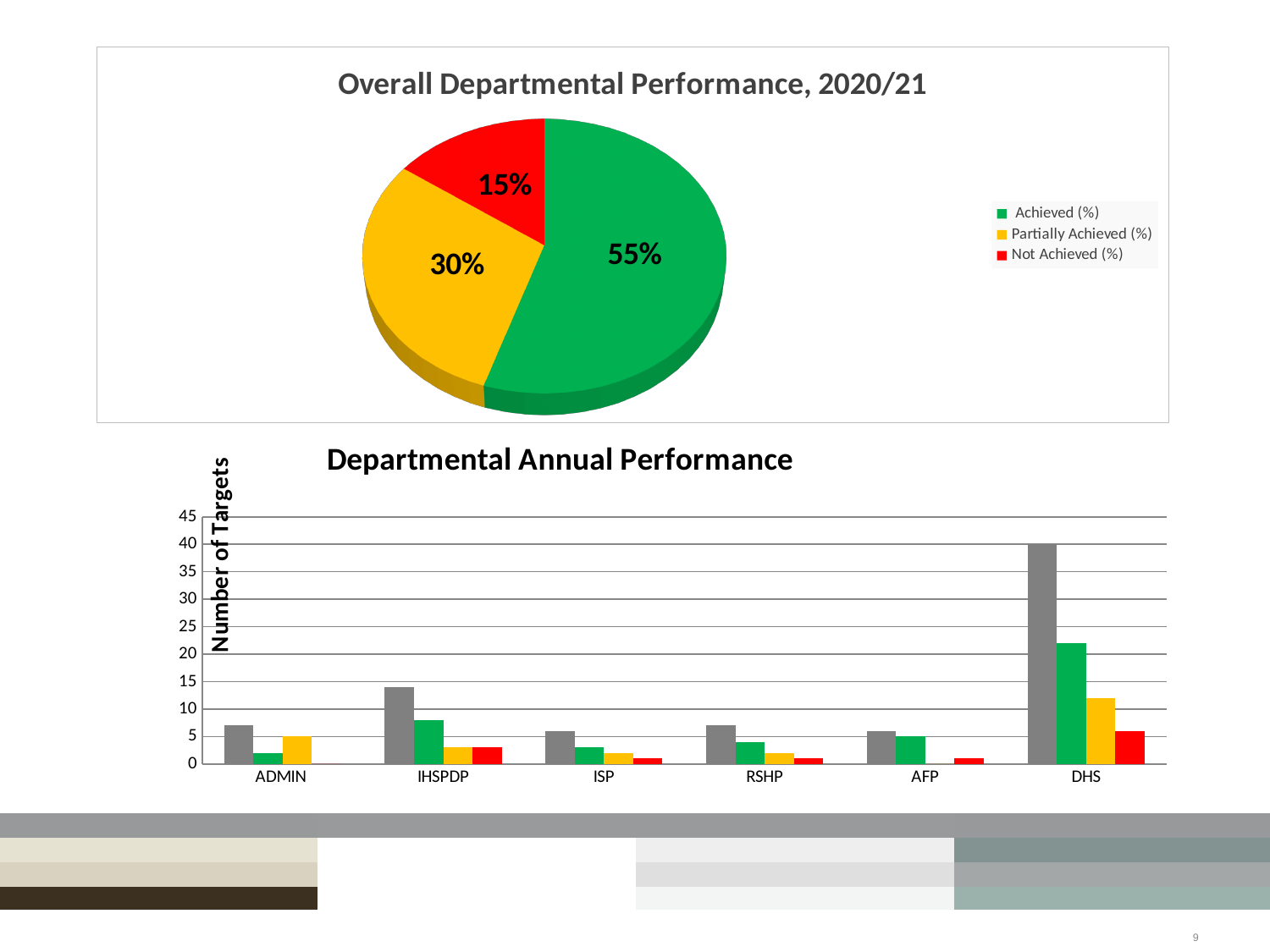
In the 'Departmental Annual Performance' chart, is the gray bar for IHSPDP greater or less than 10? greater In the pie chart titled 'Overall Departmental Performance, 2020/21', which category has the smallest share? Not Achieved (%) In the 'Departmental Annual Performance' chart, which department has the tallest gray bar? DHS In the pie chart titled 'Overall Departmental Performance, 2020/21', how many entries does the legend list? 3 In the 'Departmental Annual Performance' chart, how many departments are shown on the x axis? 6 In the pie chart titled 'Overall Departmental Performance, 2020/21', which category has the largest share? Achieved (%) In the pie chart titled 'Overall Departmental Performance, 2020/21', what percentage is shown for Not Achieved (%)? 15% What kind of chart is the 'Departmental Annual Performance' chart at the bottom of the slide? bar chart In the 'Departmental Annual Performance' chart, is the gray bar for DHS greater or less than 30? greater In the pie chart titled 'Overall Departmental Performance, 2020/21', what is the difference in percentage points between Achieved (%) and Partially Achieved (%)? 25 In the pie chart titled 'Overall Departmental Performance, 2020/21', what percentage is shown for Partially Achieved (%)? 30% In the pie chart titled 'Overall Departmental Performance, 2020/21', what percentage is shown for Achieved (%)? 55%